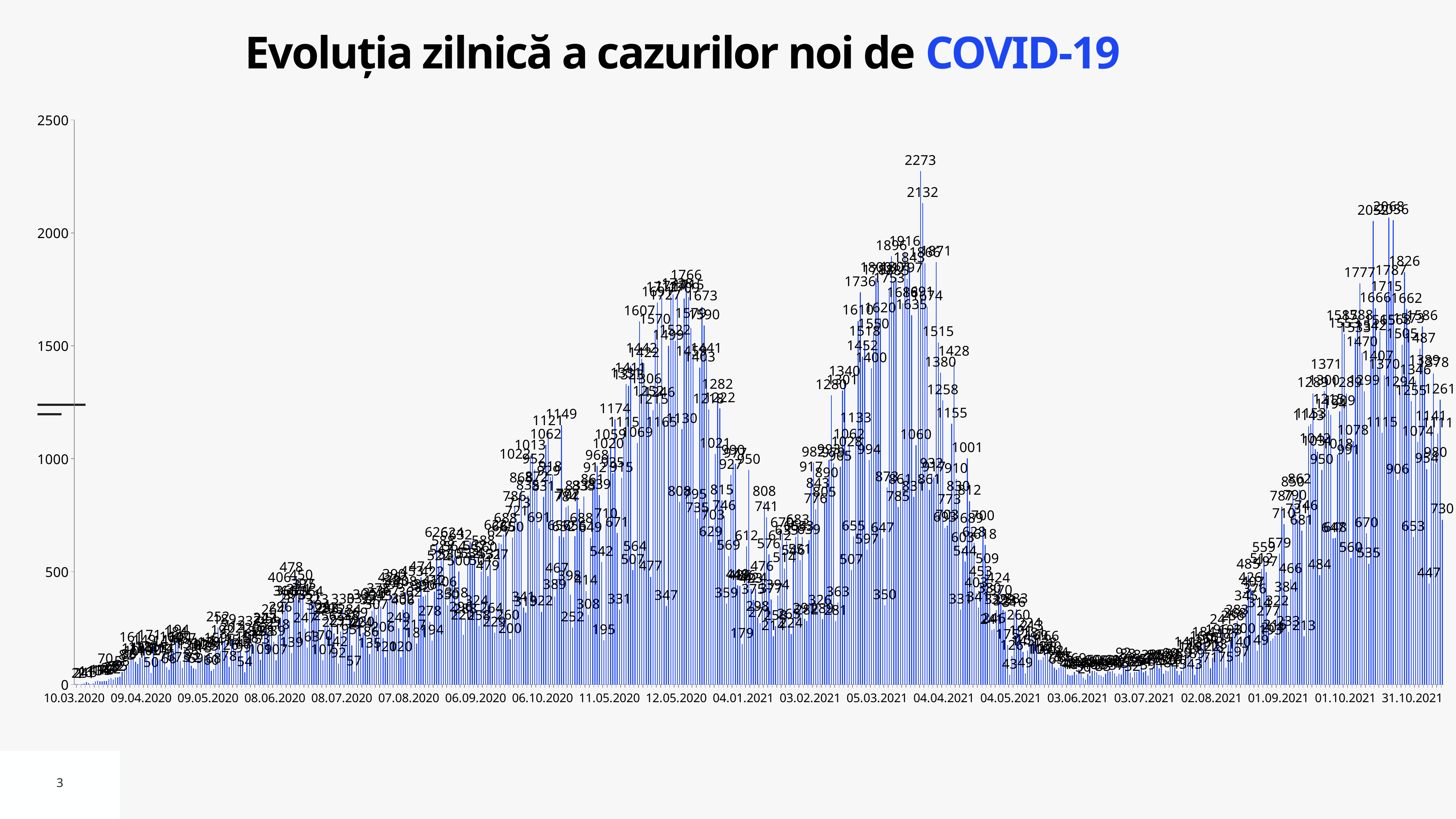
What is the first date shown on the horizontal axis? 10.03.2020 Is the highest value on the chart greater or less than 2000? greater What kind of chart is shown on the slide? bar chart What is the title of the chart? Evoluția zilnică a cazurilor noi de COVID-19 What is the last date shown on the horizontal axis? 31.10.2021 Are the values around 03.07.2021 greater or less than 500? less Which is larger: the peak value near 04.04.2021 (2273) or the peak value near 12.05.2020 (1766)? 2273 Do the values rise or fall between 04.05.2021 and 03.06.2021? fall Do the values rise or fall between 10.03.2020 and 09.04.2020? rise What is the highest daily value labelled on the chart? 2273 What is the topmost tick value on the vertical axis? 2500 What is the difference between the two highest labelled values, 2273 and 2132? 141